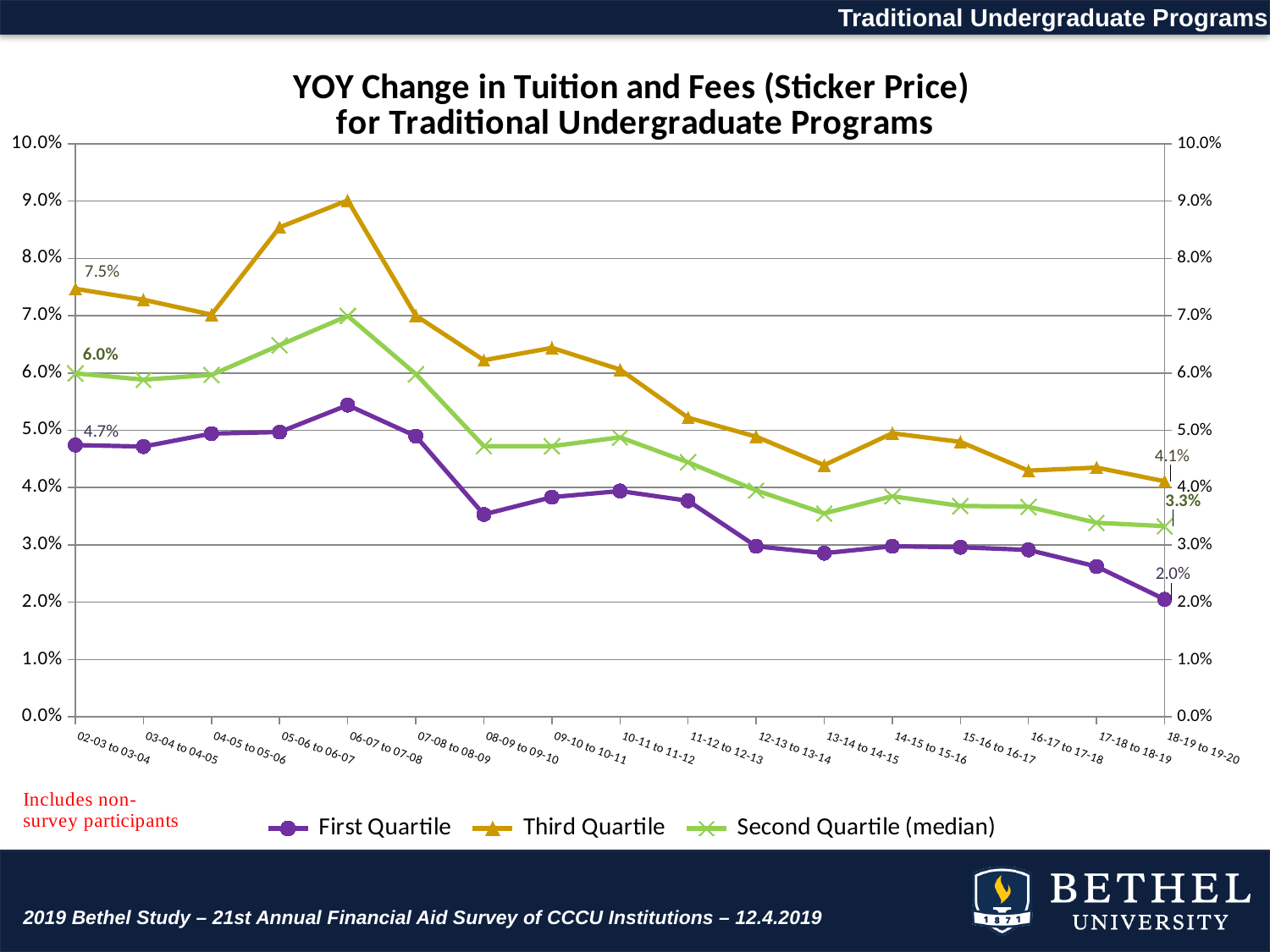
What is the First Quartile value for 18-19 to 19-20? 2.0% What is the difference between the First Quartile values for 02-03 to 03-04 and 18-19 to 19-20? 2.7% How many academic-year periods are plotted on the x axis? 17 By how much did the Third Quartile value fall from 02-03 to 03-04 to 18-19 to 19-20? 3.4% Which is larger for 02-03 to 03-04, the Third Quartile or the First Quartile? Third Quartile Is the Third Quartile value for 06-07 to 07-08 greater or less than 8.0%? greater What kind of chart is shown on the slide? Line chart Does the First Quartile line rise or fall overall from 02-03 to 03-04 to 18-19 to 19-20? Fall How many series does the legend list? 3 What is the Third Quartile value for 02-03 to 03-04? 7.5% In which period does the Third Quartile reach its highest value? 06-07 to 07-08 What is the Second Quartile (median) value for 18-19 to 19-20? 3.3%